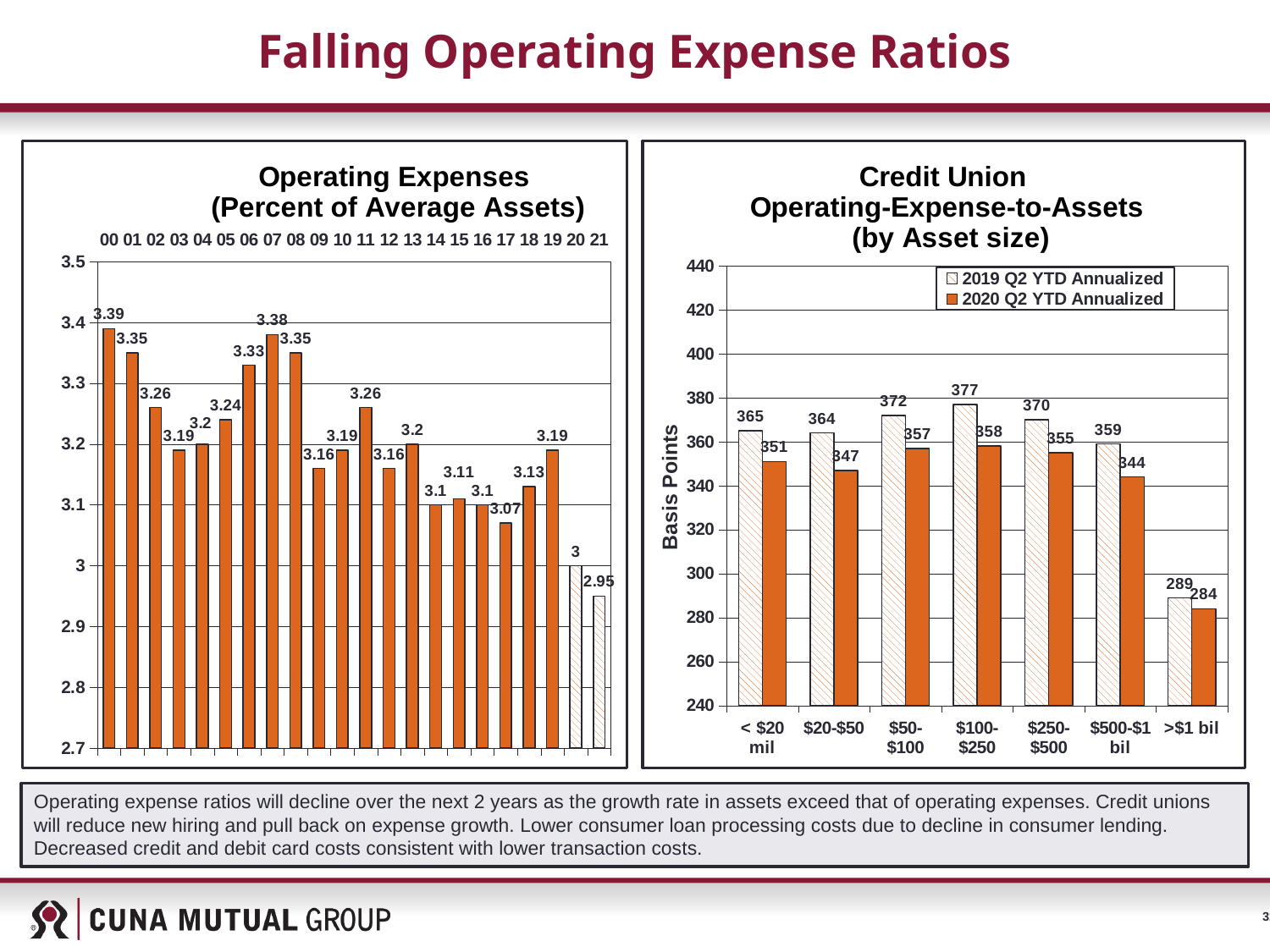
In the left chart, Operating Expenses (Percent of Average Assets), how many years are plotted? 22 In the left chart, Operating Expenses (Percent of Average Assets), do the values generally rise or fall from year 00 to year 21? fall In the right chart, Credit Union Operating-Expense-to-Assets (by Asset size), which asset group has the lowest 2020 Q2 YTD Annualized value? >$1 bil In the left chart, Operating Expenses (Percent of Average Assets), which year has the lowest value? 21 In the left chart, Operating Expenses (Percent of Average Assets), what is the difference between the values for year 00 and year 21? 0.44 In the left chart, Operating Expenses (Percent of Average Assets), what is the value for year 21? 2.95 In the right chart, Credit Union Operating-Expense-to-Assets (by Asset size), what is the difference between the 2019 and 2020 Q2 YTD Annualized values for the $100-$250 group? 19 In the right chart, Credit Union Operating-Expense-to-Assets (by Asset size), how many series does the legend list? 2 In the right chart, Credit Union Operating-Expense-to-Assets (by Asset size), which asset group has the highest 2019 Q2 YTD Annualized value? $100-$250 What kind of chart is the right chart, Credit Union Operating-Expense-to-Assets (by Asset size)? bar chart In the right chart, Credit Union Operating-Expense-to-Assets (by Asset size), what is the 2020 Q2 YTD Annualized value for the $20-$50 asset group? 347 In the left chart, Operating Expenses (Percent of Average Assets), what is the value for year 00? 3.39